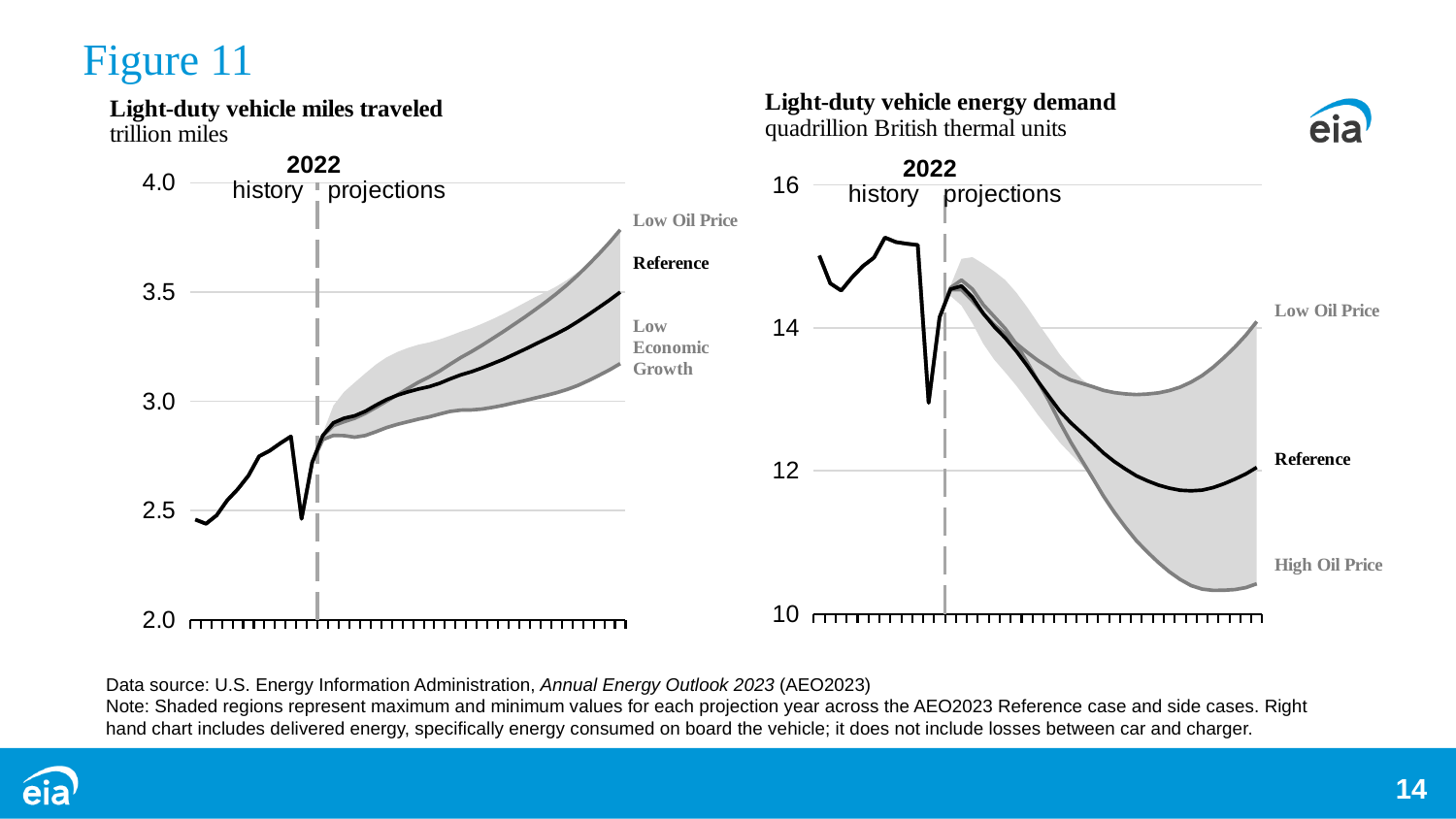
In the "Light-duty vehicle energy demand" chart, do the projected values generally rise or fall after 2022? fall In the "Light-duty vehicle miles traveled" chart, is the final value of the Low Oil Price line greater or less than 3.5? greater In the "Light-duty vehicle energy demand" chart, is the final value of the High Oil Price line greater or less than 12? less What kind of chart is the "Light-duty vehicle miles traveled" chart on the left? line chart In the "Light-duty vehicle energy demand" chart, which line ends lower at the end of the projection period, Low Oil Price or High Oil Price? High Oil Price In the "Light-duty vehicle miles traveled" chart, do the projected values generally rise or fall after 2022? rise In the "Light-duty vehicle miles traveled" chart, is the final value of the Low Economic Growth line greater or less than 3.5? less In the "Light-duty vehicle miles traveled" chart, which line ends higher at the end of the projection period, Low Oil Price or Low Economic Growth? Low Oil Price In the "Light-duty vehicle miles traveled" chart, what unit is shown under the title? trillion miles In the "Light-duty vehicle energy demand" chart, what unit is shown under the title? quadrillion British thermal units What kind of chart is the "Light-duty vehicle energy demand" chart on the right? line chart